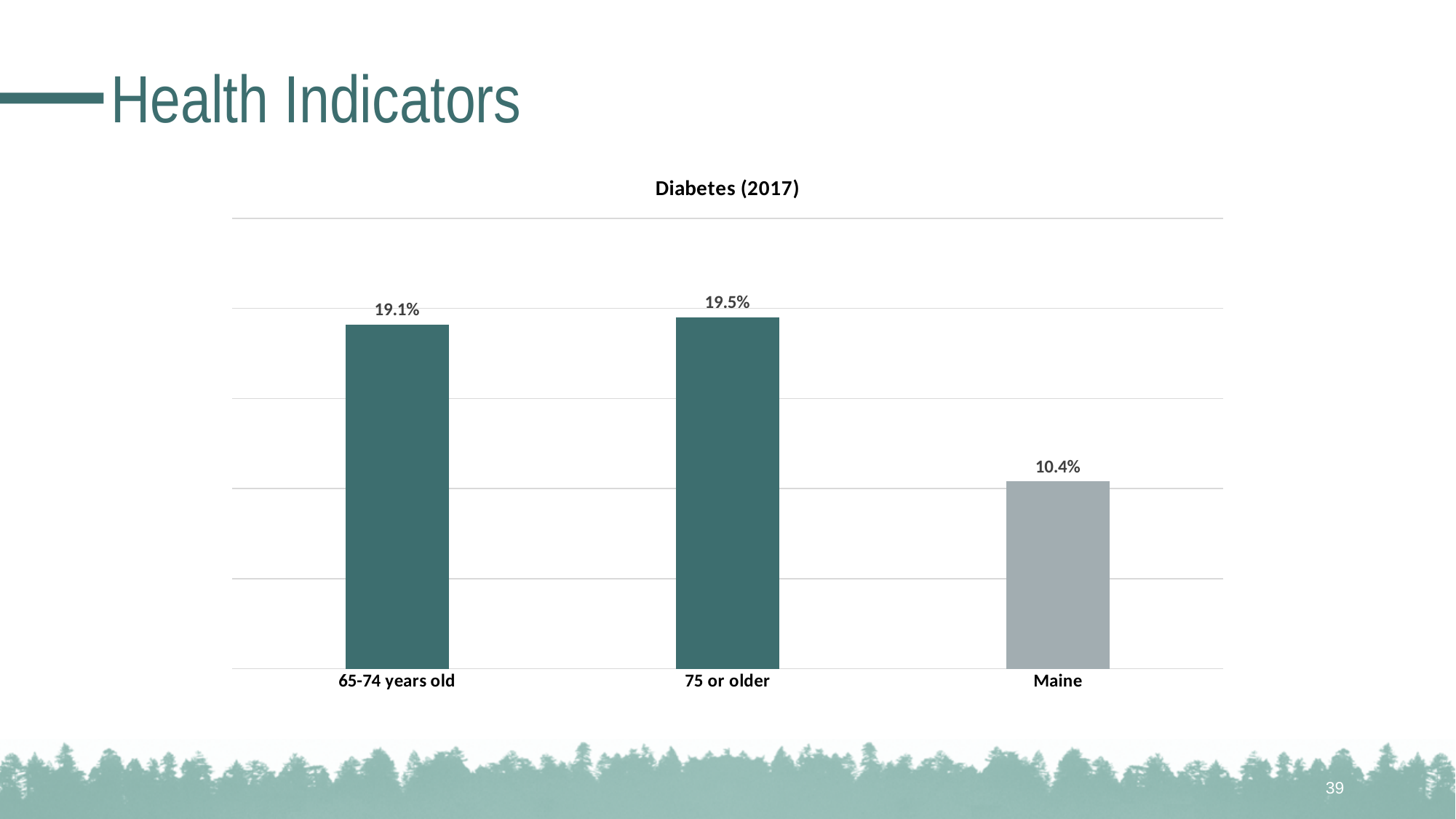
What is the diabetes rate shown for Maine? 10.4% What is the diabetes rate shown for the 65-74 years old group? 19.1% What is the title of the chart? Diabetes (2017) What kind of chart is shown on the slide? Bar chart Which category has the highest diabetes rate in the chart? 75 or older What is the diabetes rate shown for the 75 or older group? 19.5% Which category has the lowest diabetes rate in the chart? Maine What is the difference between the diabetes rate for 65-74 years old and for Maine? 8.7 percentage points Which has a higher diabetes rate, the 65-74 years old group or Maine? 65-74 years old What is the difference between the diabetes rate for 75 or older and for 65-74 years old? 0.4 percentage points What is the difference between the diabetes rate for 75 or older and for Maine? 9.1 percentage points How many categories are shown in the chart? 3